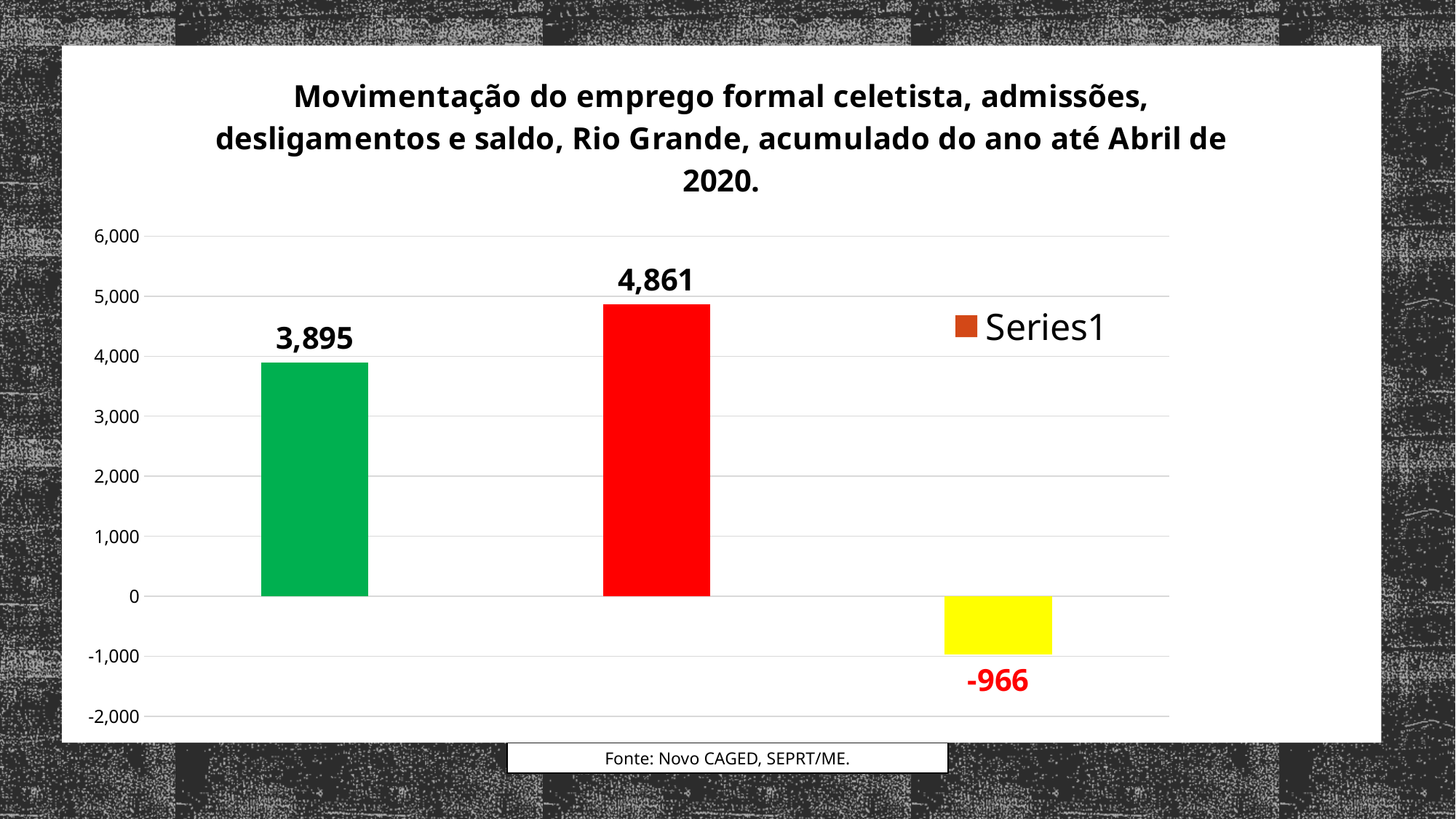
What is the value shown on the yellow bar (the rightmost bar)? -966 What is the name of the series shown in the legend? Series1 What is the difference between the value of the red bar and the value of the green bar? 966 How many series does the legend list? 1 What is the value shown on the green bar (the first bar from the left)? 3,895 Is the value of the green bar greater or less than 4,000? less Which bar has the lowest value: the green, red or yellow bar? yellow What type of chart is shown on the slide? bar chart Which is larger, the value of the green bar or the value of the red bar? the red bar How many bars are plotted in the chart? 3 What is the value shown on the red bar (the middle bar)? 4,861 Which bar has the highest value: the green, red or yellow bar? red